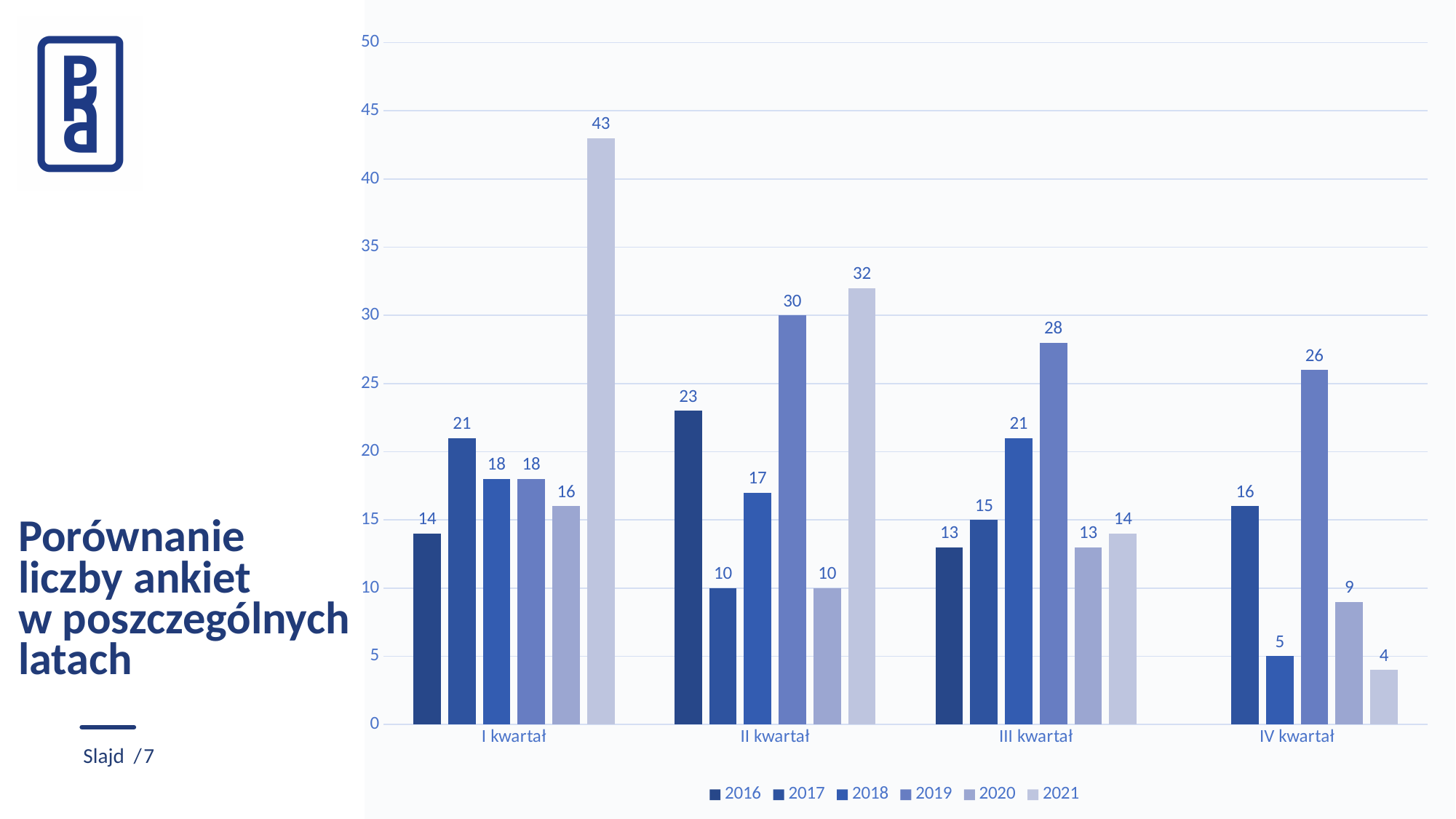
How many series does the legend list? 6 Which year has the highest value in III kwartał? 2019 What is the value for 2019 in IV kwartał? 26 What is the difference between the 2021 and 2019 values in II kwartał? 2 What is the value for 2016 in III kwartał? 13 Which is larger in II kwartał: the value for 2016 or the value for 2018? 2016 How many quarter categories are shown on the x axis? 4 What is the title of the slide? Porównanie liczby ankiet w poszczególnych latach What is the value for 2021 in I kwartał? 43 What is the value for 2019 in II kwartał? 30 What type of chart is shown on the slide? bar chart Which year has the highest value in I kwartał? 2021